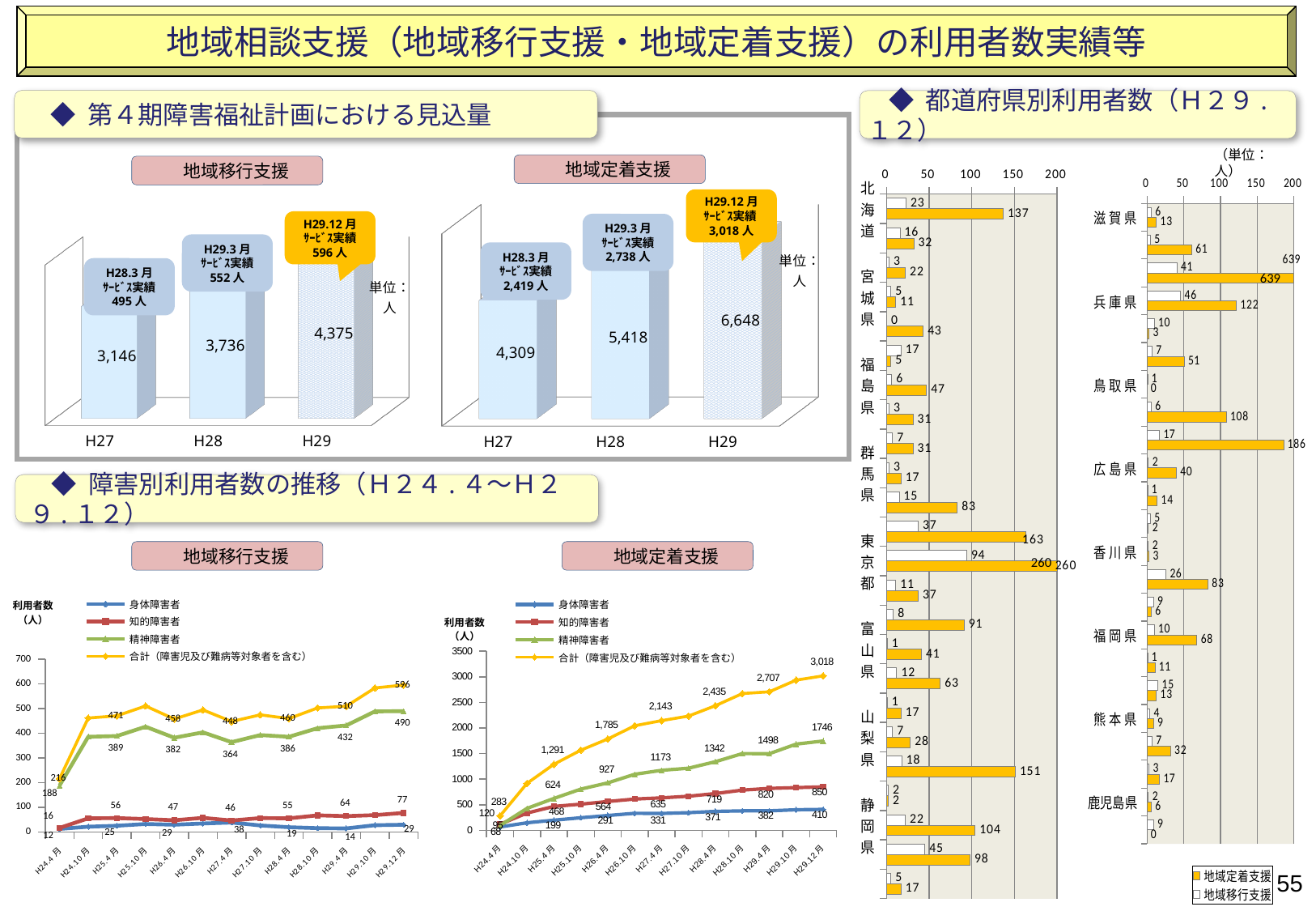
In the 地域移行支援 line chart under 障害別利用者数の推移, how many series does the legend list? 4 In the 都道府県別利用者数（Ｈ２９．１２） chart on the right, how many series does the legend list? 2 In the 地域定着支援 bar chart under 第４期障害福祉計画における見込量, what is the value for H29? 6,648 In the 地域移行支援 bar chart under 第４期障害福祉計画における見込量, which year has the highest value? H29 In the 地域定着支援 line chart under 障害別利用者数の推移, does the 合計 line rise or fall from H24.4月 to H29.12月? Rise In the 地域定着支援 line chart under 障害別利用者数の推移, which is larger at H29.12月: 知的障害者 or 身体障害者? 知的障害者 In the 地域定着支援 bar chart under 第４期障害福祉計画における見込量, how many years are plotted? 3 What kind of chart is used for the 地域移行支援 見込量 under 第４期障害福祉計画における見込量? Bar chart In the 地域定着支援 bar chart under 第４期障害福祉計画における見込量, what is the difference between the H29 and H27 values? 2,339 In the 地域移行支援 line chart under 障害別利用者数の推移, what is the 合計 value at H29.12月? 596 In the 地域移行支援 bar chart under 第４期障害福祉計画における見込量, what is the value for H28? 3,736 In the 地域定着支援 line chart under 障害別利用者数の推移, what is the 精神障害者 value at H29.12月? 1746